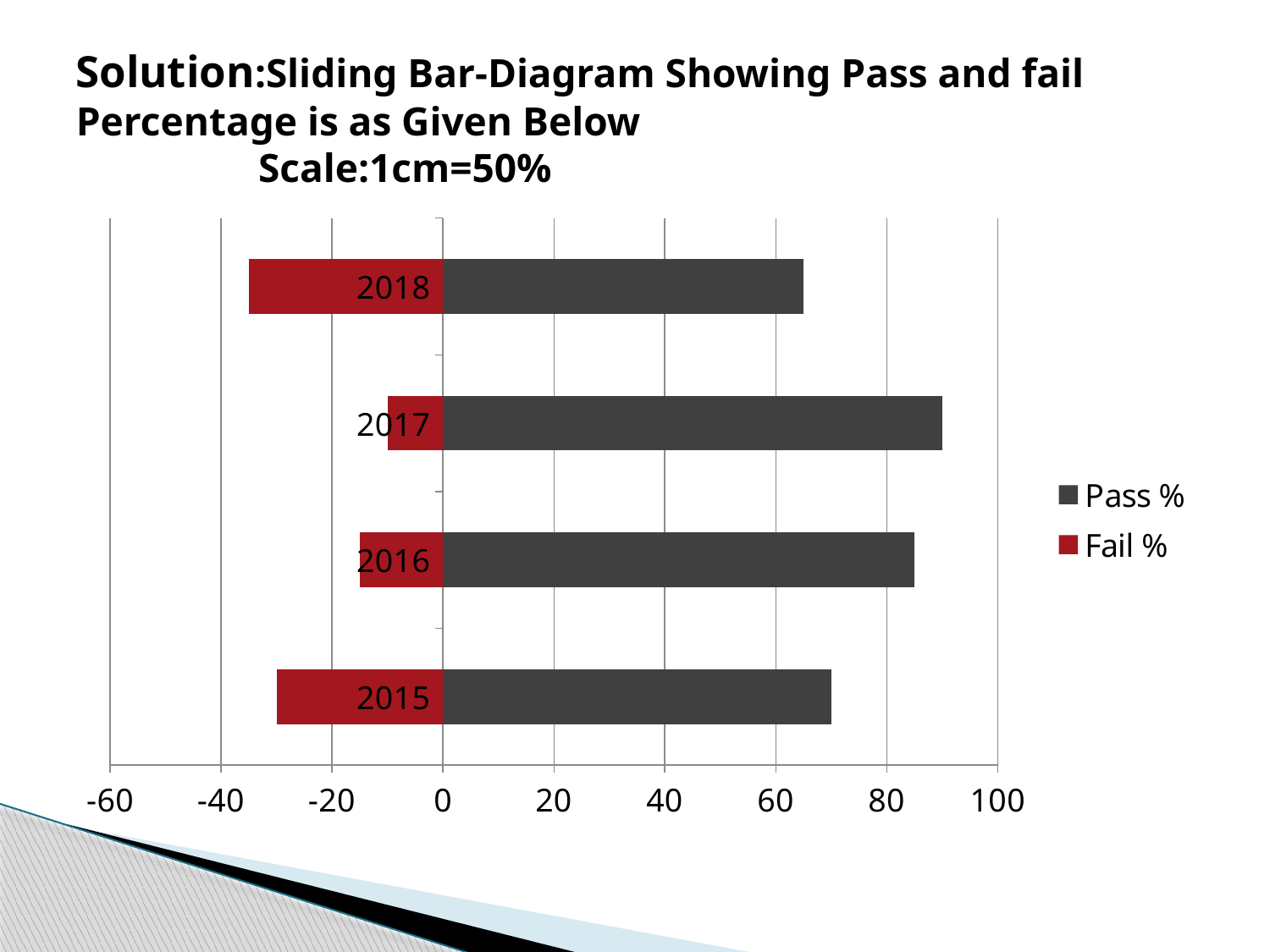
What colour are the Fail % bars? red Which year has the highest Pass %? 2017 Which year has the largest Fail % bar? 2018 Is the Pass % value for 2015 greater or less than 80? less Is the Pass % value for 2018 greater or less than 60? greater How many series does the legend list? 2 Which year has the lowest Pass %? 2018 Which year has the smallest Fail % bar? 2017 Which is larger, the Pass % for 2016 or the Pass % for 2015? 2016 What kind of chart is shown on the slide? bar chart Is the Pass % value for 2017 greater or less than 80? greater How many years are plotted on the chart? 4